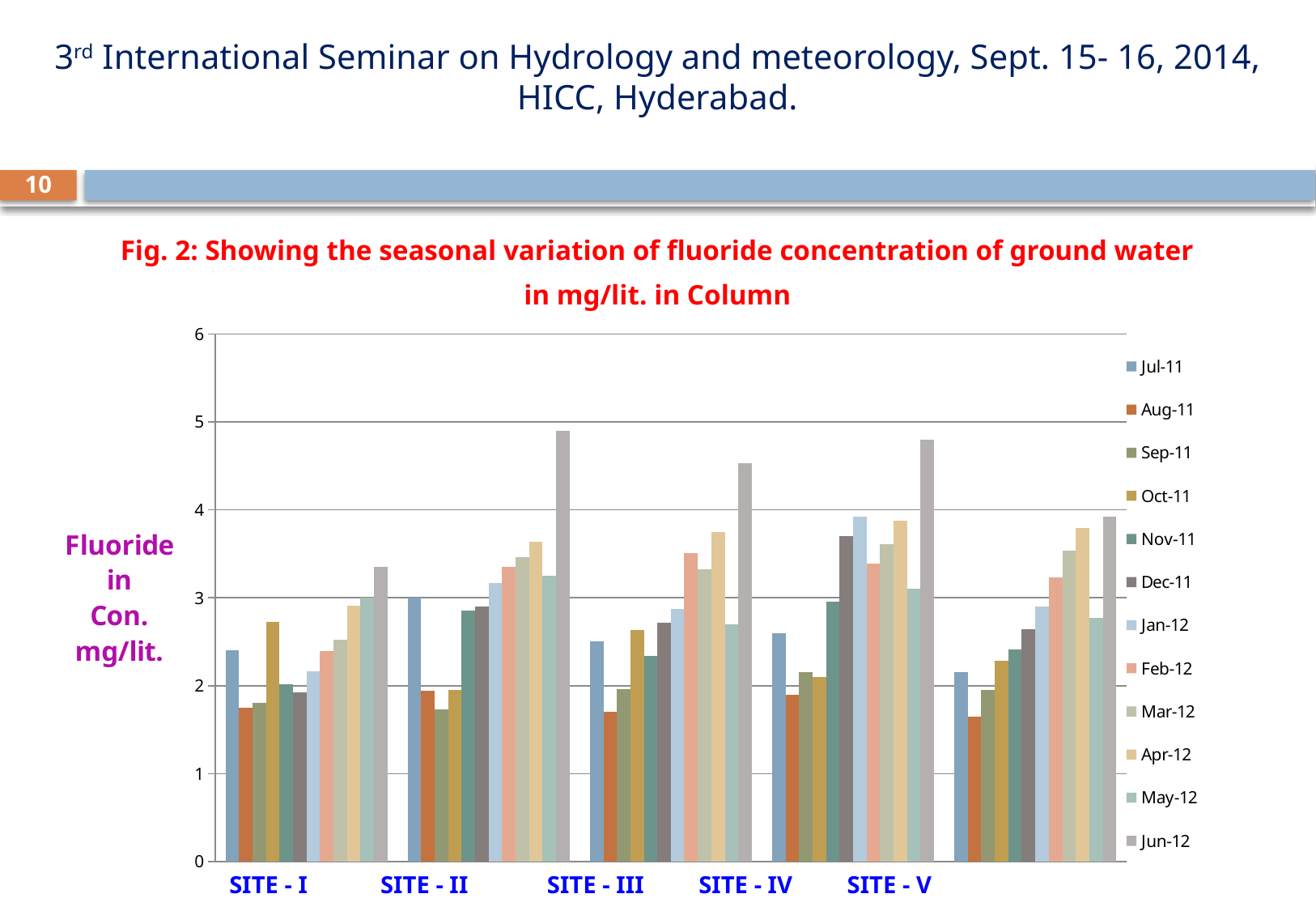
Is the Dec-11 value for SITE - V greater or less than 3? less How many sites are shown on the x axis of the chart? 5 What kind of chart is shown on the slide? Bar chart What is the label on the vertical axis of the chart? Fluoride in Con. mg/lit. Is the Jun-12 value for SITE - II greater or less than 4? greater Which is larger, the Jul-11 value for SITE - I or the Jul-11 value for SITE - II? SITE - II How many series does the chart legend list? 12 Which is larger, the Dec-11 value for SITE - I or the Dec-11 value for SITE - V? SITE - V Is the Aug-11 value for SITE - III greater or less than 2? less Which month has the highest fluoride value at SITE - V? Jun-12 Which month has the lowest fluoride value at SITE - III? Aug-11 Which month has the highest fluoride value at SITE - I? Jun-12